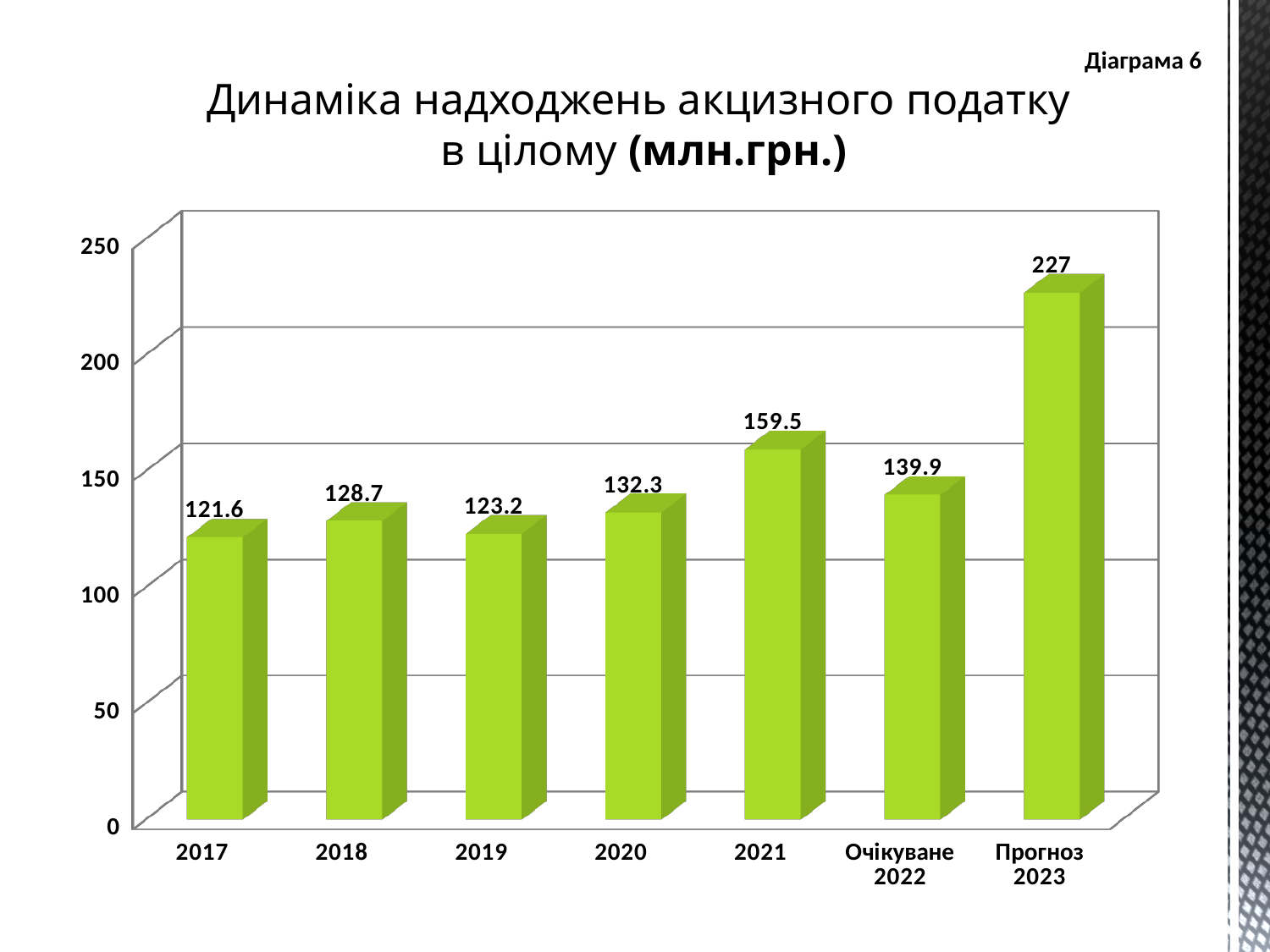
Which is larger, the value for 2020 or the value for 2018? 2020 Is the value for 2021 greater or less than 150? greater What kind of chart is shown on the slide? bar chart What is the difference between the values for 2018 and 2019? 5.5 Which category has the highest value? Прогноз 2023 What is the value for 2021? 159.5 What is the difference between the values for Прогноз 2023 and 2021? 67.5 What is the value for Очікуване 2022? 139.9 What is the value for 2017? 121.6 How many categories are shown on the x axis? 7 Which category has the lowest value? 2017 What is the title of the chart? Динаміка надходжень акцизного податку в цілому (млн.грн.)